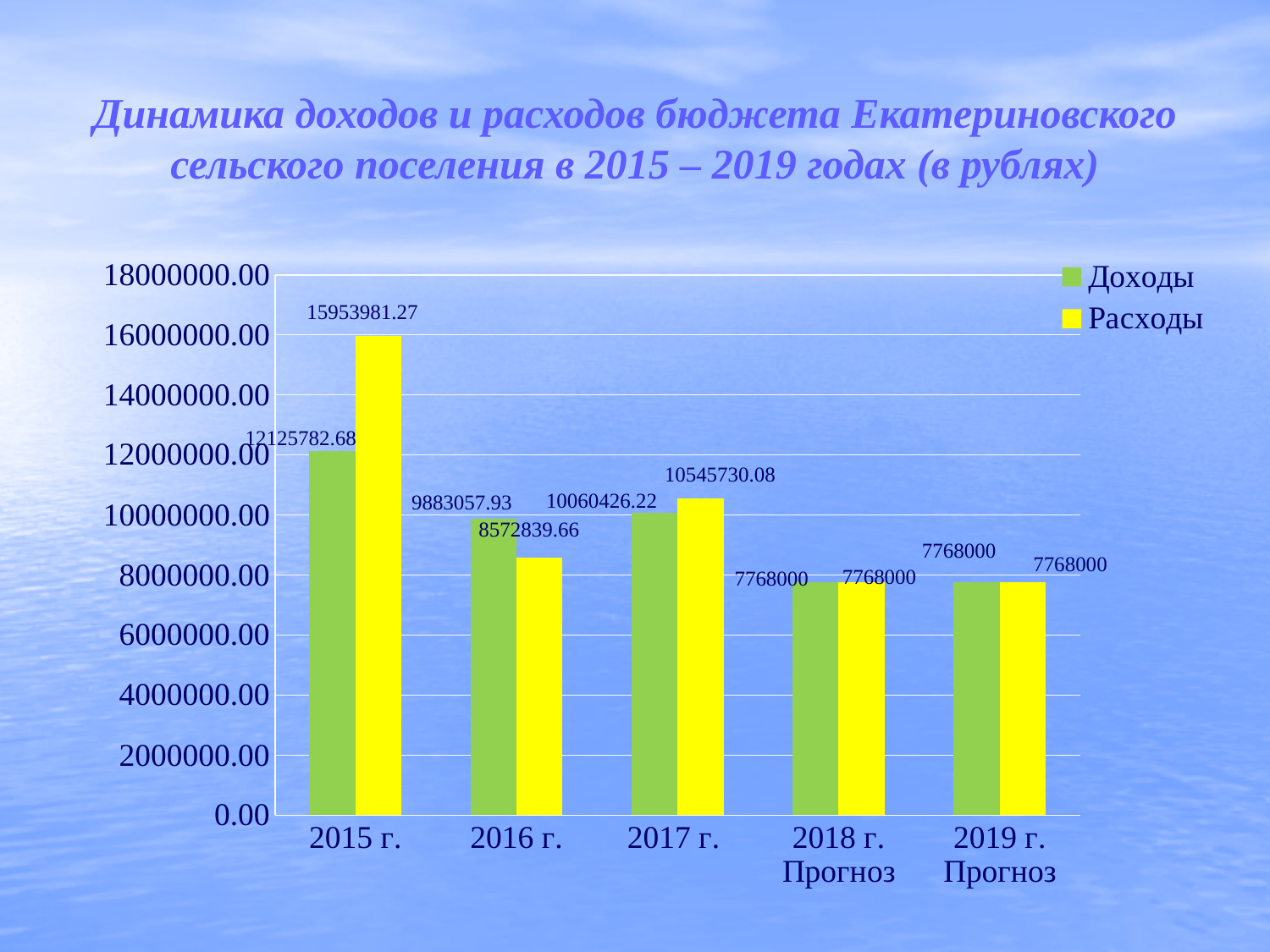
Which series is shown in yellow? Расходы In which year is Расходы the highest? 2015 г. Which is larger in 2016 г., Доходы or Расходы? Доходы Is the value of Доходы for 2015 г. greater or less than 12000000.00? greater What is the value of Доходы for 2016 г.? 9883057.93 What is the value of Расходы for 2015 г.? 15953981.27 What is the value of Расходы for 2017 г.? 10545730.08 What is the difference between Расходы and Доходы in 2015 г.? 3828198.59 How many year categories are shown on the x axis? 5 What is the value of Доходы for 2019 г. Прогноз? 7768000 What type of chart is shown on the slide? Bar chart How many series does the legend list? 2